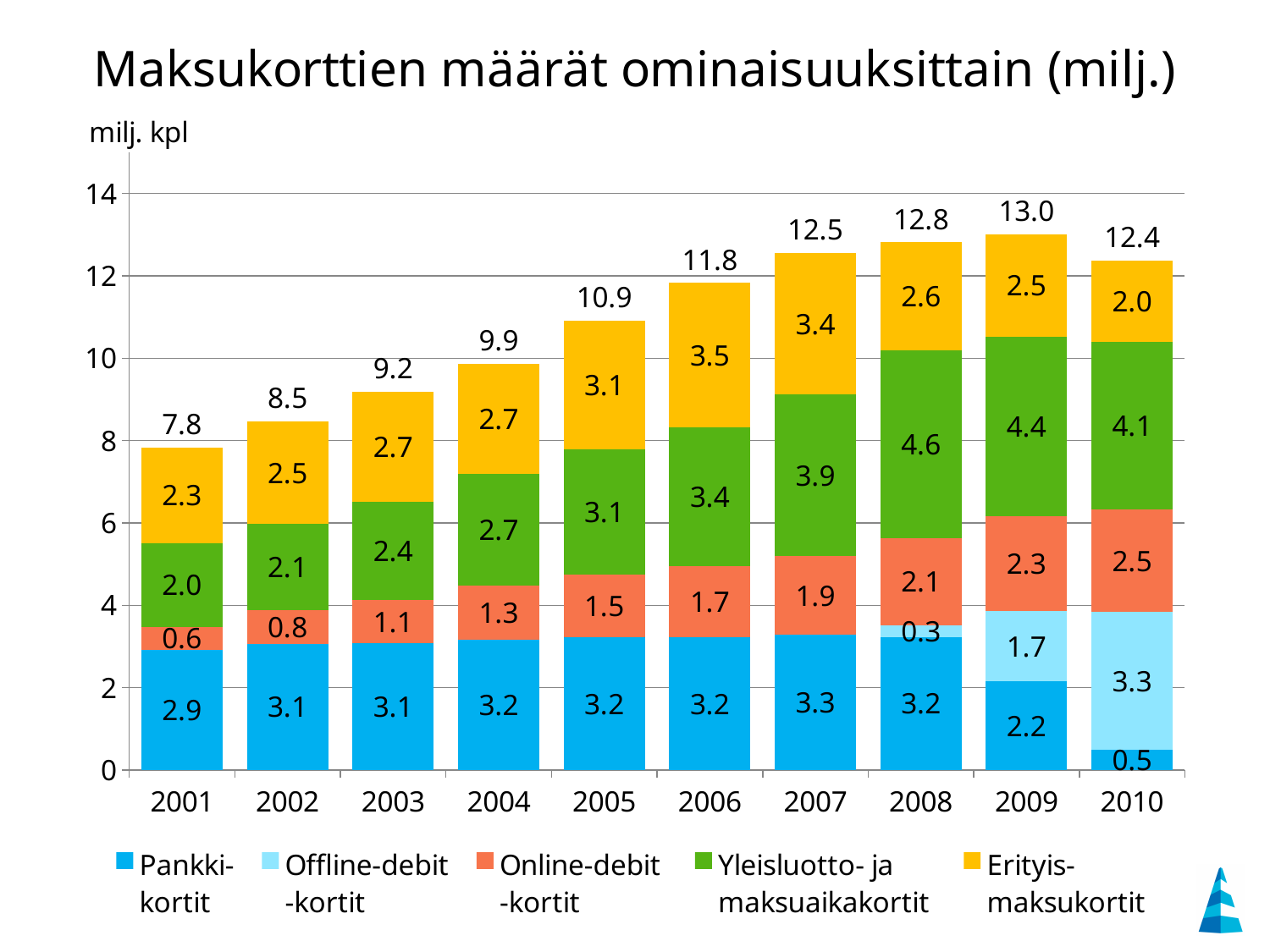
In 2010, which is larger: Online-debit-kortit or Erityismaksukortit? Online-debit-kortit What is the value for Offline-debit-kortit in 2010? 3.3 How much larger is the Yleisluotto- ja maksuaikakortit value in 2008 than in 2001? 2.6 How many series does the legend list? 5 Which year has the lowest total number of cards? 2001 What is the value for Pankkikortit in 2001? 2.9 What kind of chart is shown on the slide? Stacked bar chart What is the total of the stacked bar for 2009? 13.0 Does the total number of cards rise or fall from 2001 to 2009? Rise What is the value for Erityismaksukortit in 2007? 3.4 How many years are shown on the x axis? 10 Which year has the highest total number of cards? 2009